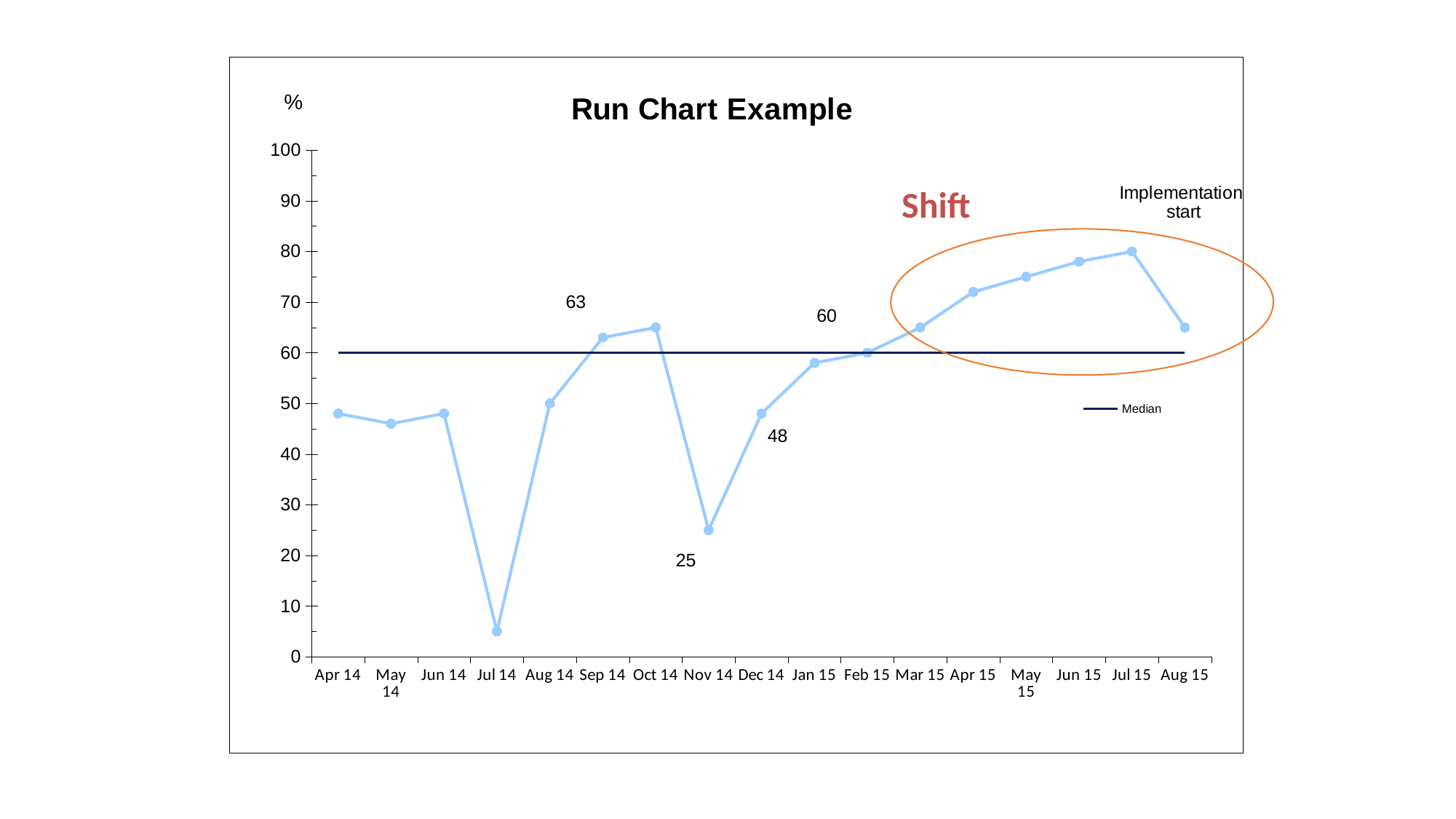
Which month has the highest value? Jul 15 What is the difference between the values for Sep 14 and Nov 14? 38 What is the value for Nov 14? 25 Which is larger, the value for Sep 14 or the value for Dec 14? Sep 14 What is the value for Dec 14? 48 Which month has the lowest value? Jul 14 How many data points are plotted on the line? 17 What kind of chart is this? line chart Is the value for Jul 14 greater or less than 10? less What is the value for Feb 15? 60 Is the value for Jul 15 greater or less than 70? greater What is the value for Sep 14? 63